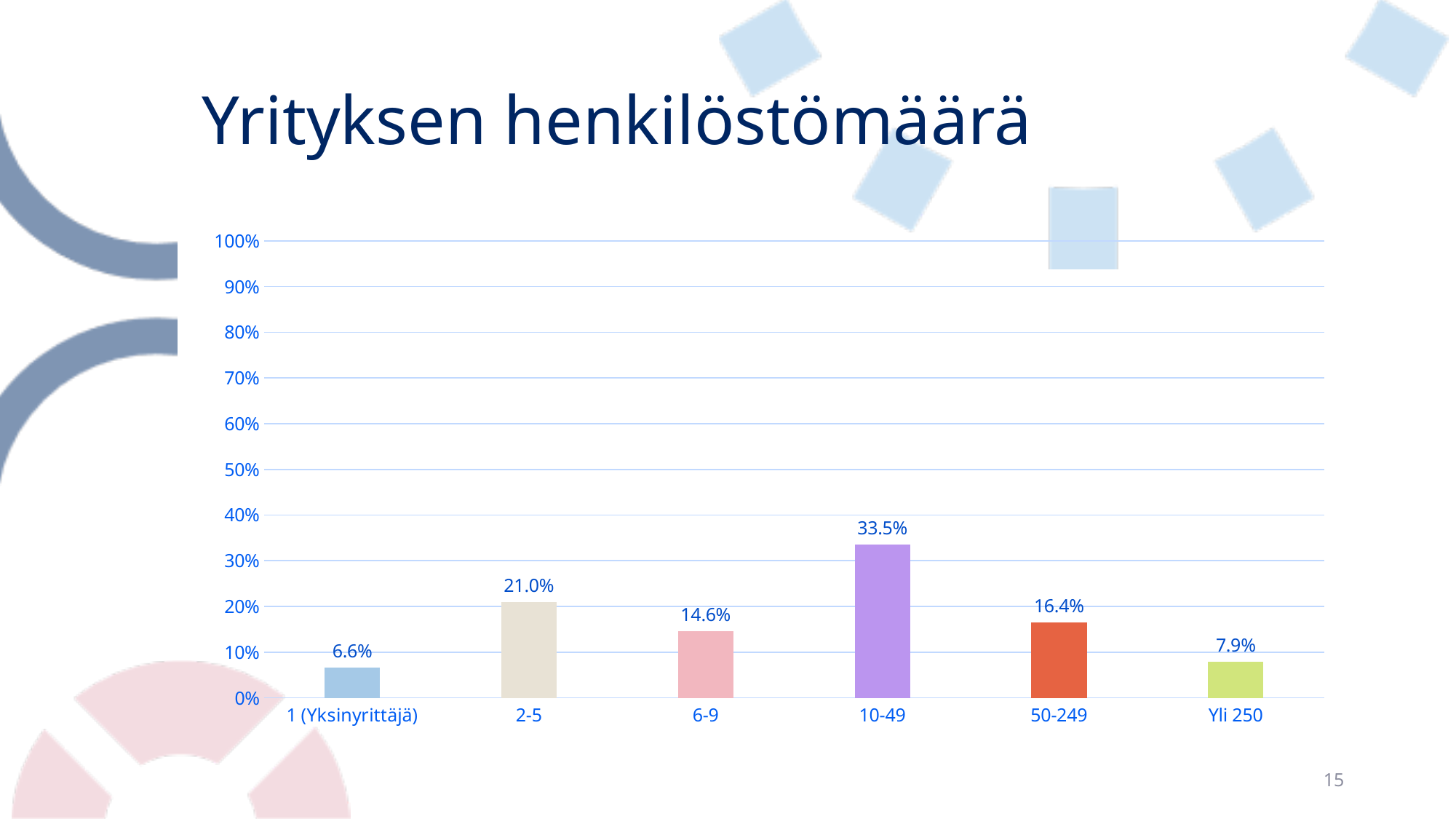
What is the difference between the values for 2-5 and 6-9? 6.4% Is the value for 2-5 greater or less than 30%? less What is the value for the Yli 250 category? 7.9% What kind of chart is shown on the slide? bar chart What is the title of the slide? Yrityksen henkilöstömäärä Which category has the lowest value? 1 (Yksinyrittäjä) What is the value for the 10-49 category? 33.5% What is the difference between the values for 10-49 and 50-249? 17.1% Which is larger, the value for 50-249 or the value for 6-9? 50-249 What is the value for the 1 (Yksinyrittäjä) category? 6.6% How many categories are shown on the x axis? 6 Which category has the highest value? 10-49